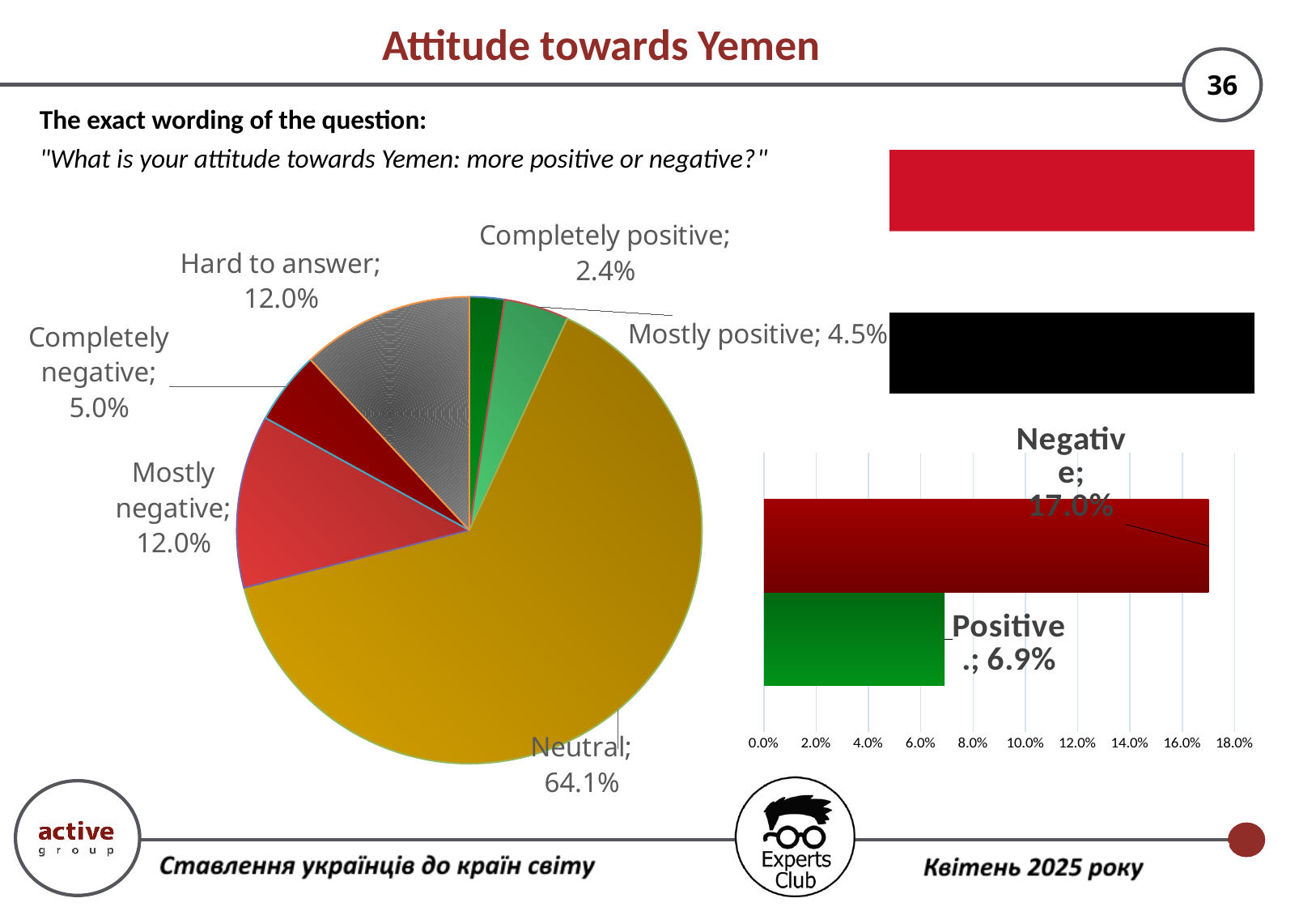
In the pie chart, which is larger: Completely negative or Mostly positive? Completely negative In the pie chart, which category has the smallest slice? Completely positive In the pie chart, which category has the largest slice? Neutral In the pie chart, what share of respondents answered Neutral? 64.1% In the bar chart on the right, what is the value for Positive? 6.9% In the pie chart, what is the difference between Mostly positive and Completely positive? 2.1% In the pie chart, how many categories are shown? 6 What type of chart is shown on the right side of the slide? Bar chart In the pie chart, what is the value for Mostly negative? 12.0% In the bar chart on the right, what is the difference between Negative and Positive? 10.1% In the bar chart on the right, what is the value for Negative? 17.0% In the pie chart, what is the value for Completely positive? 2.4%